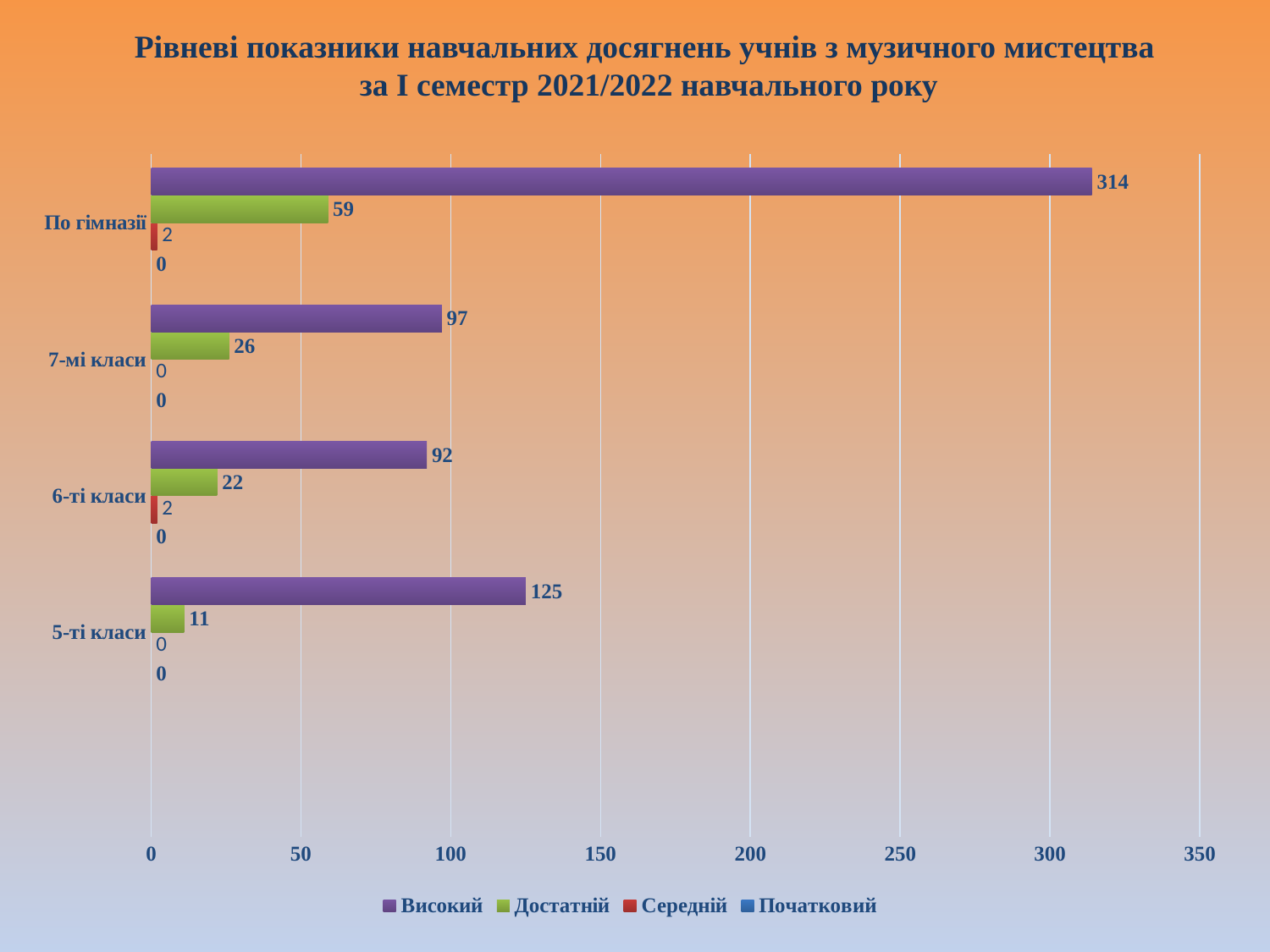
How many series does the legend list? 4 What is the value of Високий for По гімназії? 314 Among the class groups (5-ті, 6-ті, 7-мі класи), which has the lowest Достатній value? 5-ті класи Which is larger, the Високий value for 7-мі класи or for 6-ті класи? 7-мі класи Which category has the highest Високий value? По гімназії What kind of chart is shown on the slide? bar chart What is the value of Початковий for 7-мі класи? 0 How many categories are shown on the y axis? 4 What is the difference between the Високий values for 5-ті класи and 6-ті класи? 33 What is the value of Достатній for 7-мі класи? 26 What is the value of Достатній for 5-ті класи? 11 What is the value of Середній for 6-ті класи? 2